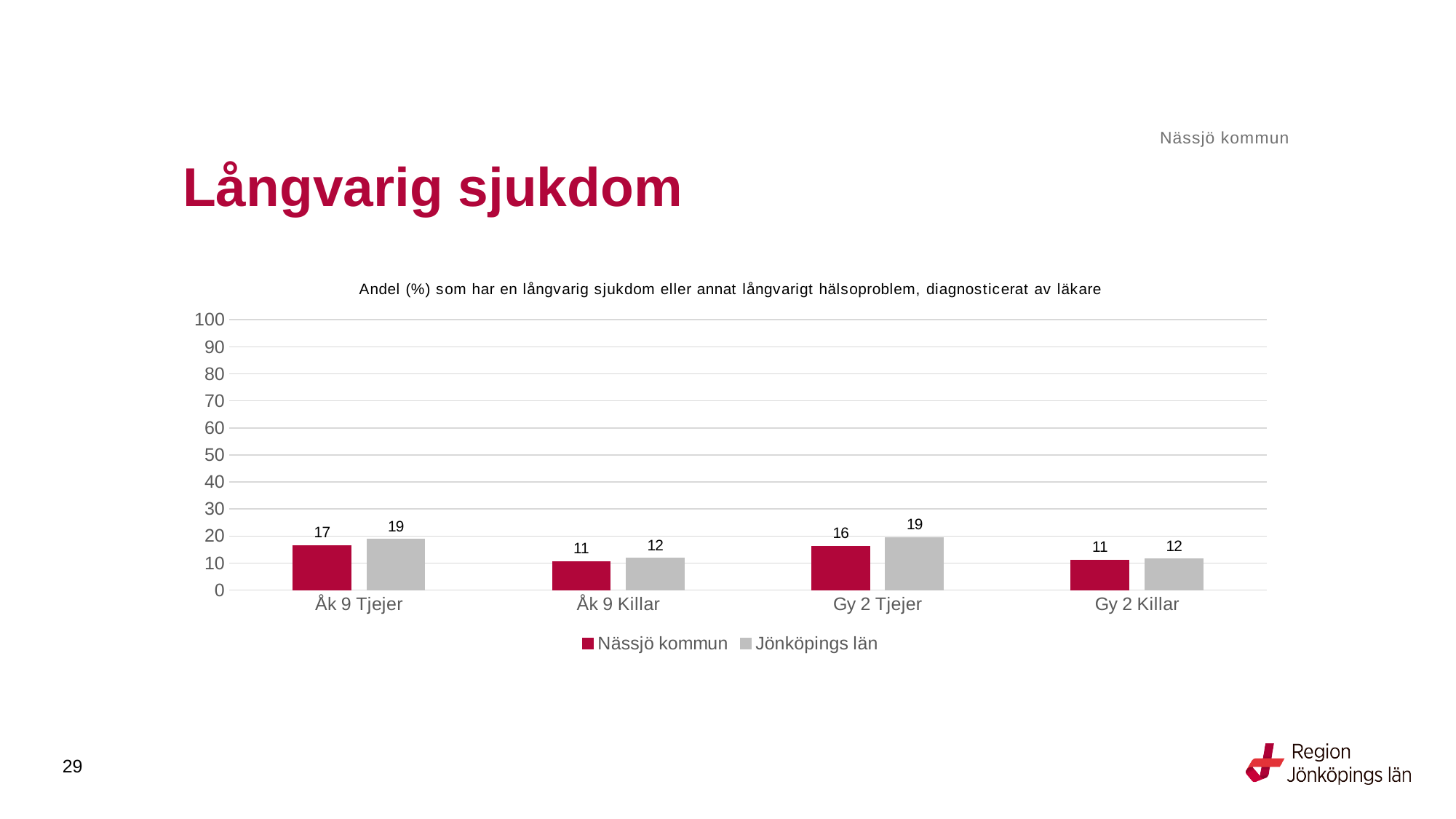
Which category has the highest value for Nässjö kommun? Åk 9 Tjejer Is the value for Jönköpings län in Åk 9 Tjejer greater or less than 30? less What kind of chart is shown on the slide? Bar chart Which category has the lowest value for Nässjö kommun? Åk 9 Killar and Gy 2 Killar (both 11) Which is larger in the Åk 9 Killar category, Nässjö kommun or Jönköpings län? Jönköpings län What is the value for Nässjö kommun in the Gy 2 Killar category? 11 What is the value for Nässjö kommun in the Åk 9 Tjejer category? 17 What is the difference between Jönköpings län and Nässjö kommun in the Gy 2 Tjejer category? 3 What is the title of the chart? Andel (%) som har en långvarig sjukdom eller annat långvarigt hälsoproblem, diagnosticerat av läkare What is the value for Jönköpings län in the Gy 2 Tjejer category? 19 How many categories are shown on the x axis? 4 How many series does the legend list? 2